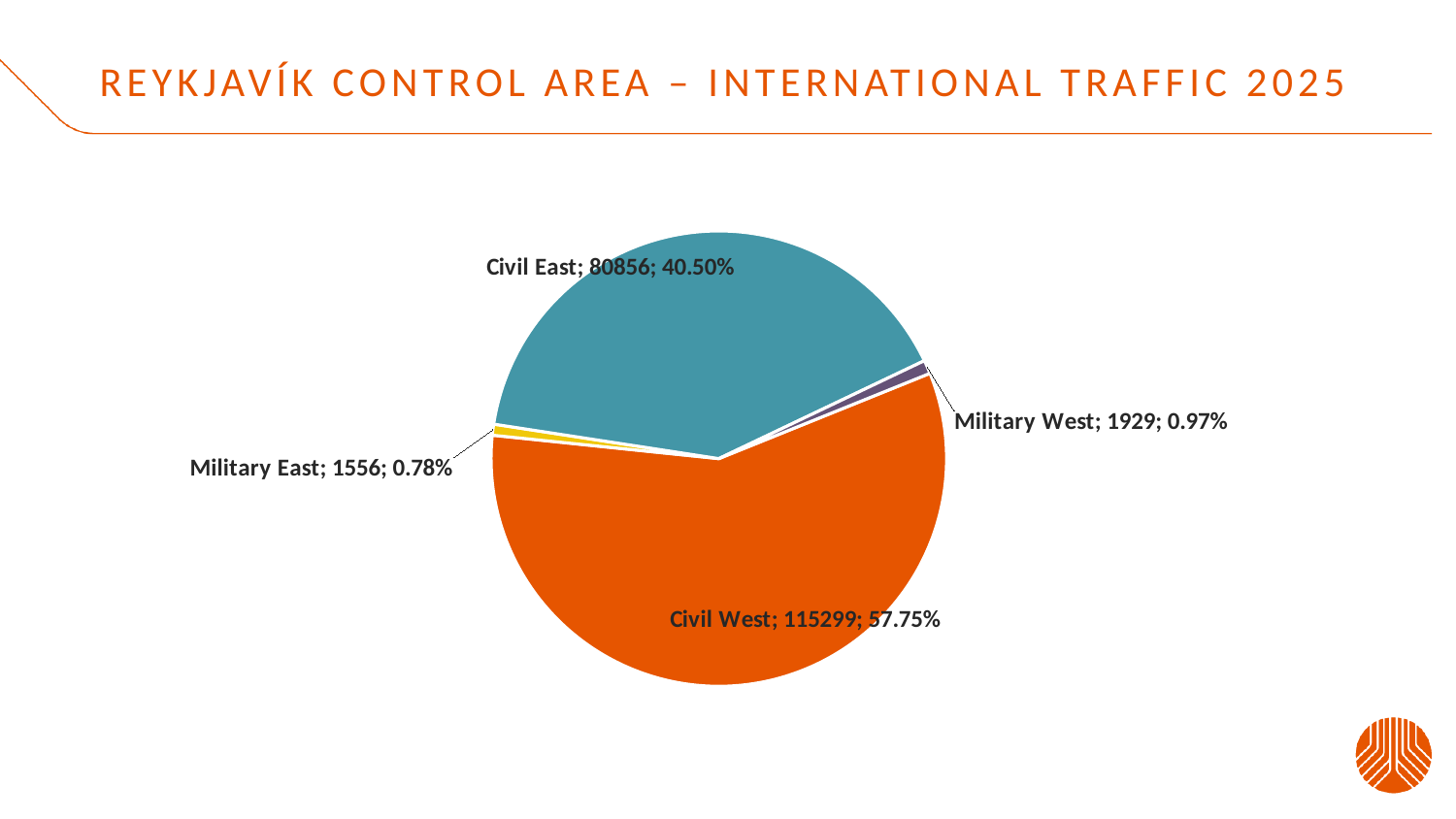
How many slices does the pie chart have? 4 What is the difference between the Civil West and Civil East values? 34443 What is the title of the slide? Reykjavík Control Area – International Traffic 2025 What is the value for Military West? 1929 What share of the pie does Civil West represent? 57.75% What is the value for Civil East? 80856 What is the value for Civil West? 115299 Which category has the smallest slice? Military East What kind of chart is shown on the slide? Pie chart Which is larger, Military West or Military East? Military West Which category has the largest slice? Civil West What share of the pie does Military East represent? 0.78%